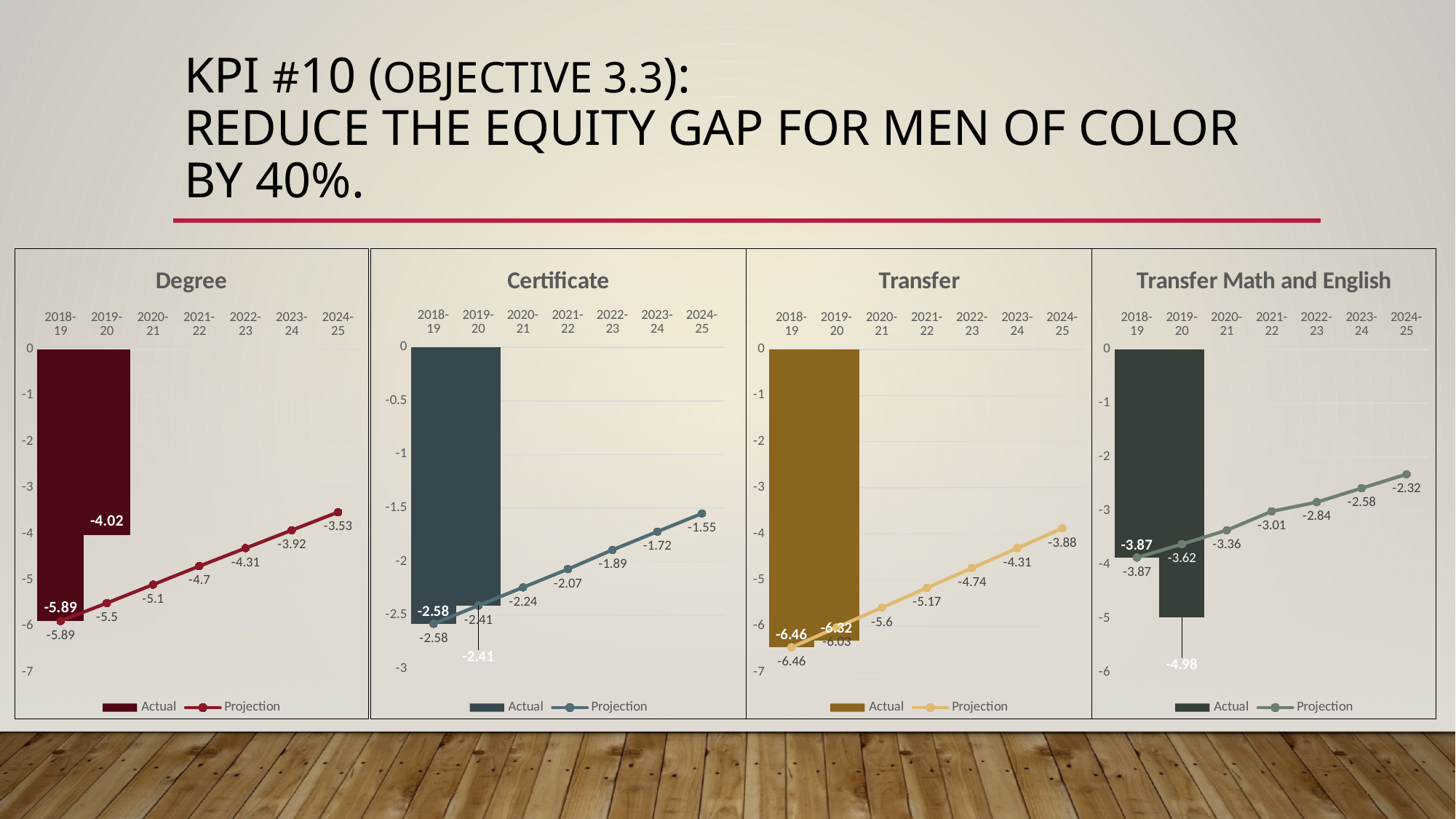
In the Transfer Math and English chart, which year has the lowest Actual value? 2019-20 In the Degree chart, what is the difference between the Projection values for 2018-19 and 2024-25? 2.36 How many series does the legend of the Degree chart list? 2 In the Certificate chart, does the Projection line rise or fall from 2018-19 to 2024-25? rise In the Certificate chart, is the Actual value for 2018-19 or 2019-20 larger? 2019-20 In the Transfer Math and English chart, what is the Actual value for 2019-20? -4.98 In the Certificate chart, what is the Projection value for 2024-25? -1.55 In the Transfer chart, what is the Actual value for 2018-19? -6.46 In the Transfer chart, what is the Projection value for 2021-22? -5.17 What are the two series named in the legend of the Transfer Math and English chart? Actual and Projection In the Degree chart, what is the Actual value for 2019-20? -4.02 How many years are shown on the x axis of the Transfer chart? 7